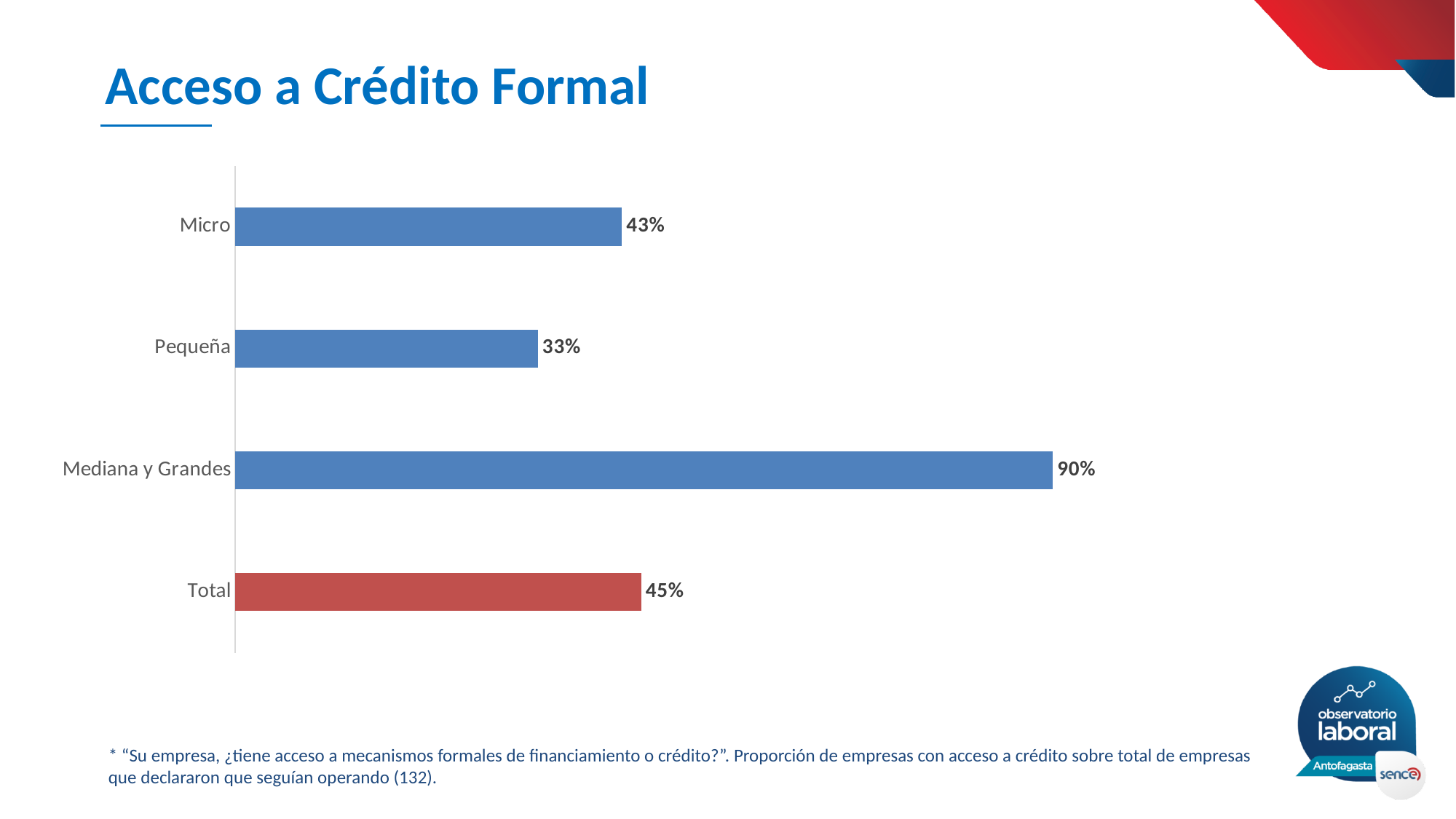
Which category's bar is coloured red rather than blue? Total What is the difference between the values for Total and Pequeña? 12% What is the value for Micro? 43% Which is larger, the value for Micro or the value for Pequeña? Micro Which category has the lowest value? Pequeña Which category has the highest value? Mediana y Grandes What kind of chart is shown on the slide? Bar chart What is the difference between the values for Mediana y Grandes and Micro? 47% What is the value for Mediana y Grandes? 90% What is the value for Total? 45% How many categories are shown in the chart? 4 What is the value for Pequeña? 33%